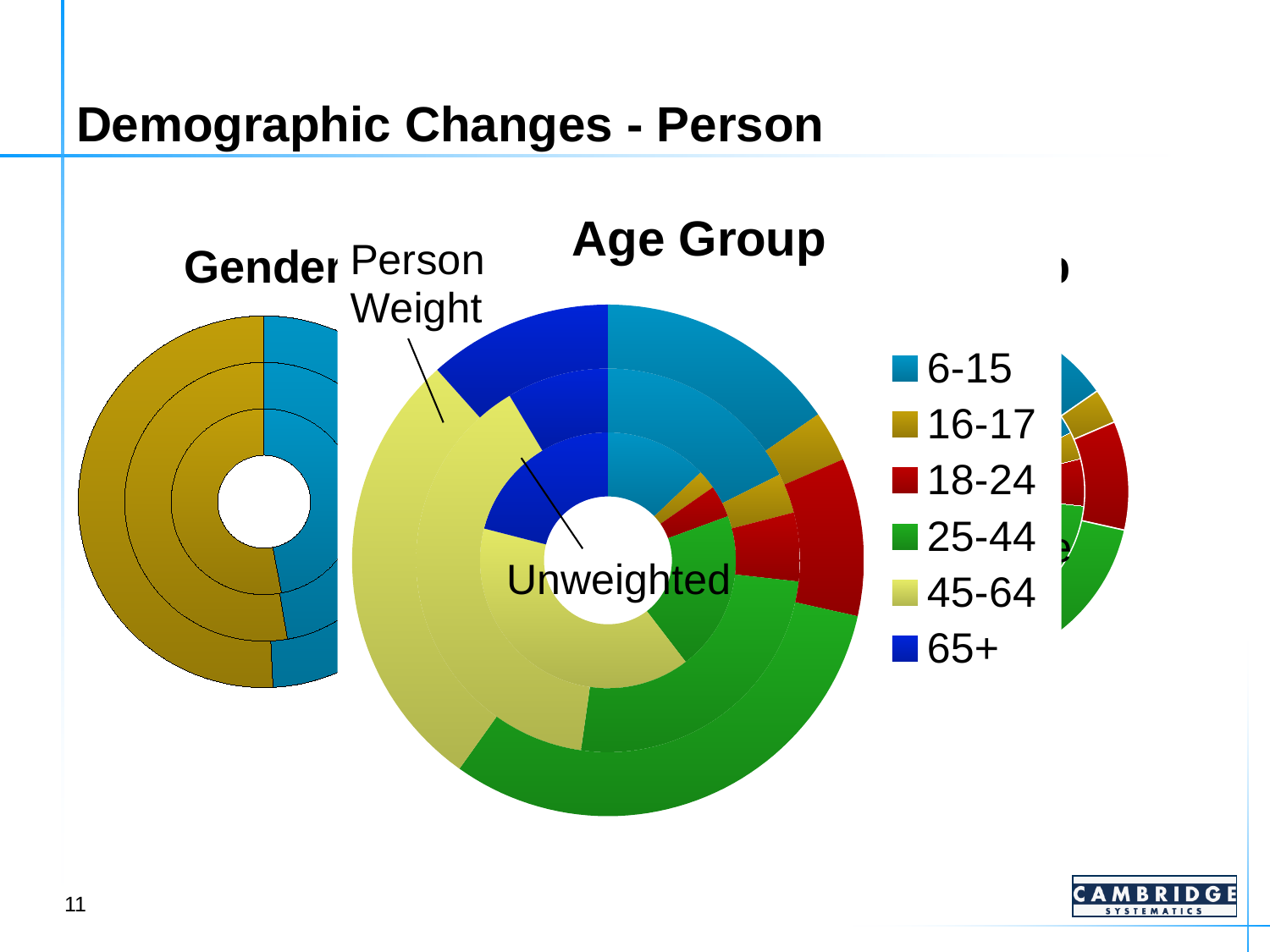
How many rings does the Age Group doughnut chart have? 3 How many age categories does the legend of the Age Group chart list? 6 In the Age Group chart, which is larger, the share for 25-44 or the share for 18-24? 25-44 In the Age Group chart, which is larger, the share for 45-64 or the share for 18-24? 45-64 In the Age Group chart, which is larger, the share for 6-15 or the share for 16-17? 6-15 In the Age Group chart, which age category has the smallest share? 16-17 In the Age Group chart, which ring is labeled 'Unweighted'? The innermost ring What kind of chart is the Age Group chart? Doughnut chart What kind of chart is the Gender chart? Doughnut chart In the Age Group chart, what colour represents the 65+ category? Blue